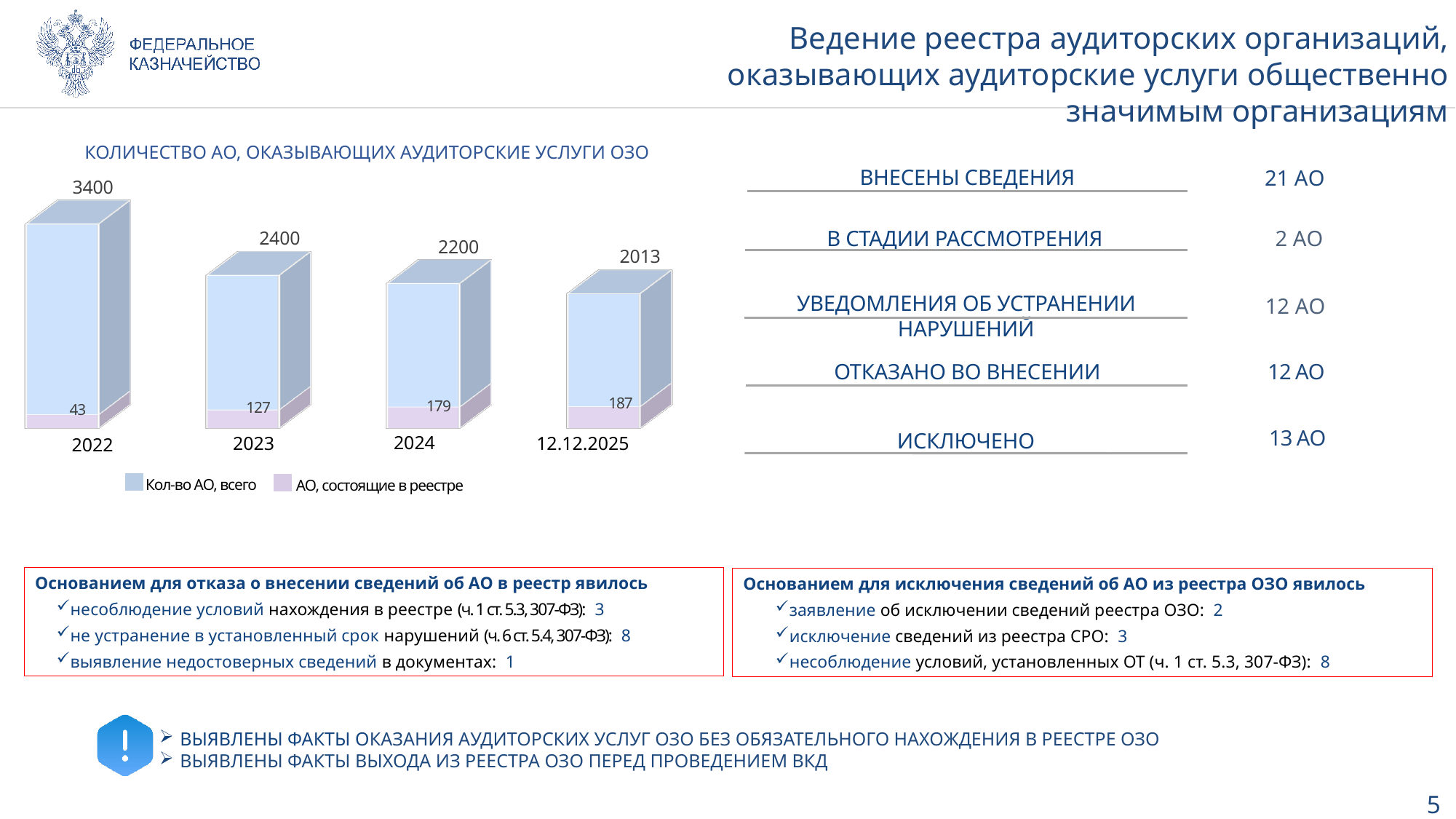
How many series does the chart legend list? 2 Does 'Кол-во АО, всего' rise or fall from 2022 to 12.12.2025? fall How many categories are shown on the x axis of the chart? 4 What is the difference between 'АО, состоящие в реестре' in 12.12.2025 and 2024? 8 In which category is 'АО, состоящие в реестре' the lowest? 2022 What is the difference between 'Кол-во АО, всего' in 2022 and 2023? 1000 What is the value of 'АО, состоящие в реестре' for 2023? 127 Which is larger: 'Кол-во АО, всего' in 2023 or in 2024? 2023 What is the value of 'АО, состоящие в реестре' for 2024? 179 In which year is 'Кол-во АО, всего' the highest? 2022 What is the value of 'Кол-во АО, всего' for 12.12.2025? 2013 What is the value of 'Кол-во АО, всего' for 2022? 3400